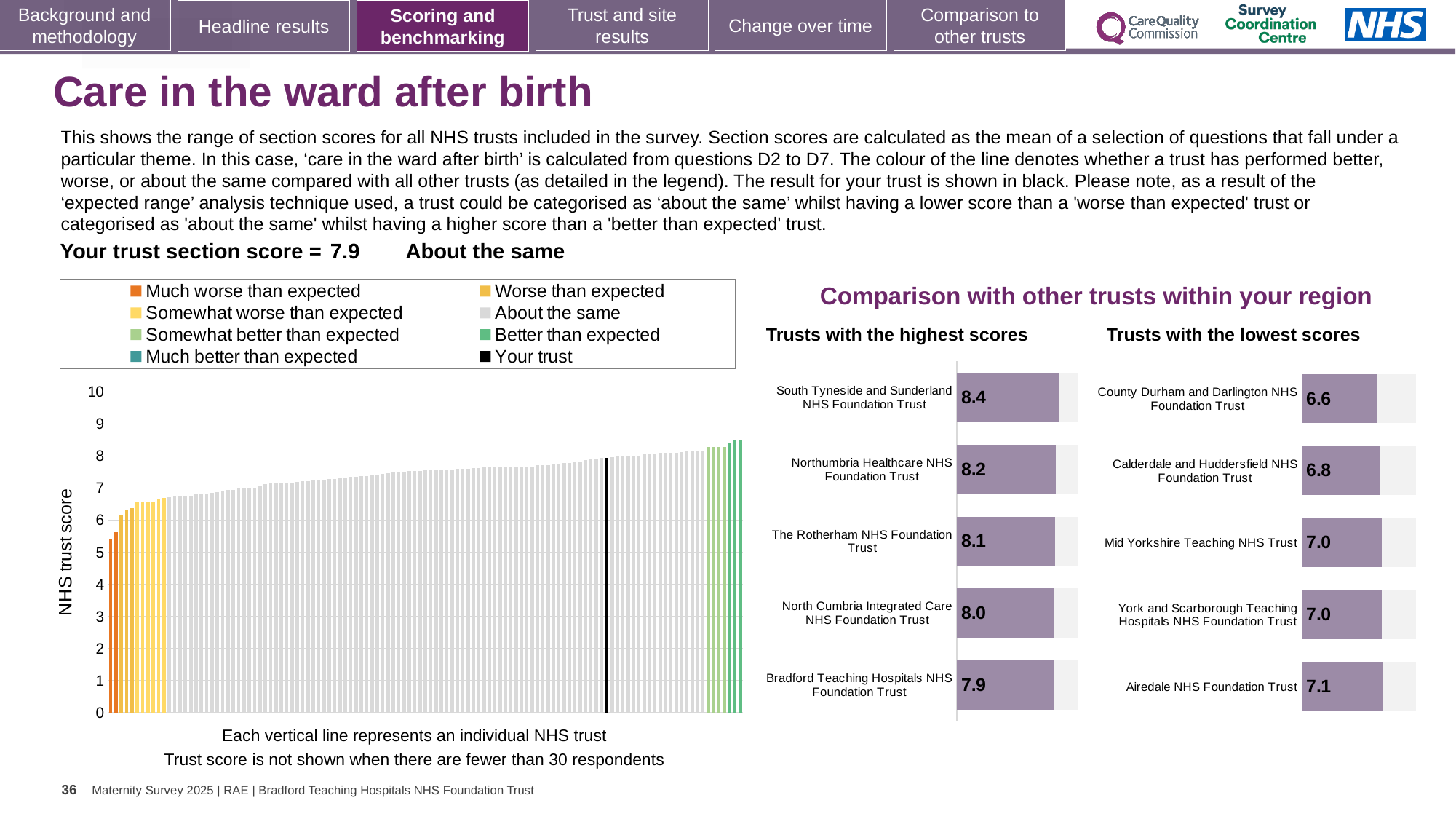
In the NHS trust score chart on the left, what is the section score for your trust (shown in black)? 7.9 In the 'Trusts with the lowest scores' chart, which trust has the lowest score? County Durham and Darlington NHS Foundation Trust In the 'Trusts with the lowest scores' chart, what is the score for Airedale NHS Foundation Trust? 7.1 In the 'Trusts with the highest scores' chart, how many trusts are shown? 5 In the NHS trust score chart on the left, do the trust scores rise or fall from left to right? Rise In the 'Trusts with the lowest scores' chart, which has the higher score: Calderdale and Huddersfield NHS Foundation Trust or Airedale NHS Foundation Trust? Airedale NHS Foundation Trust What kind of chart is the NHS trust score chart on the left of the slide? Bar chart In the NHS trust score chart on the left, how many entries does the legend list? 8 In the 'Trusts with the highest scores' chart, what is the score for South Tyneside and Sunderland NHS Foundation Trust? 8.4 In the 'Trusts with the lowest scores' chart, what is the difference between the scores of Calderdale and Huddersfield NHS Foundation Trust and County Durham and Darlington NHS Foundation Trust? 0.2 In the 'Trusts with the highest scores' chart, what is the difference between the scores of South Tyneside and Sunderland NHS Foundation Trust and Bradford Teaching Hospitals NHS Foundation Trust? 0.5 In the 'Trusts with the highest scores' chart, which trust has the highest score? South Tyneside and Sunderland NHS Foundation Trust